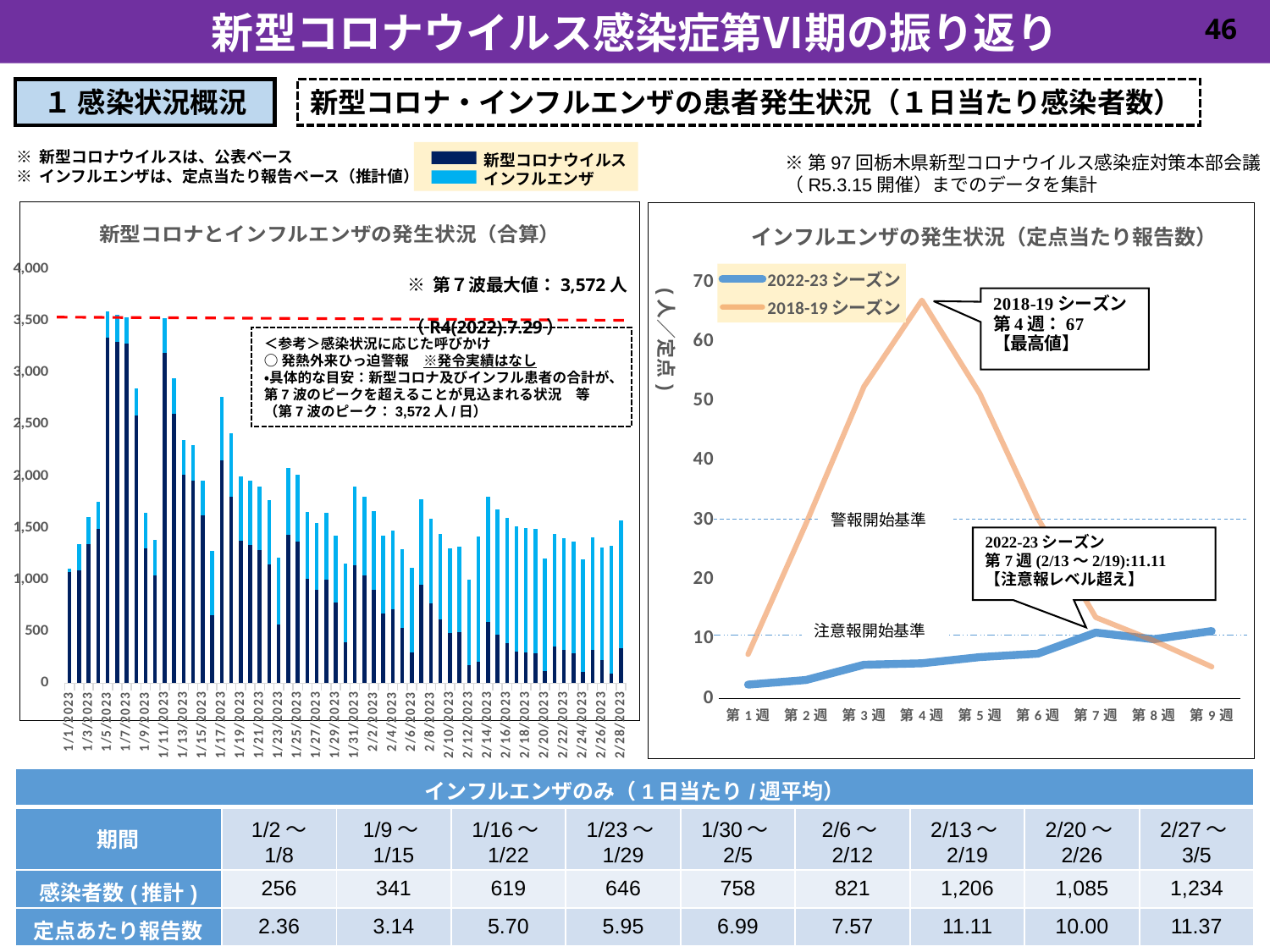
In the right chart インフルエンザの発生状況（定点当たり報告数）, what is the highest value of the 2018-19シーズン series and in which week does it occur? 67, 第4週 In the left chart 新型コロナとインフルエンザの発生状況（合算）, do the stacked totals generally rise or fall from mid-January to the end of February? fall How many series does the legend list for the right chart インフルエンザの発生状況（定点当たり報告数）? 2 What kind of chart is the left chart titled 新型コロナとインフルエンザの発生状況（合算）? bar chart In the right chart インフルエンザの発生状況（定点当たり報告数）, what is the value of the 2022-23シーズン series in 第7週? 11.11 In the left chart 新型コロナとインフルエンザの発生状況（合算）, is the stacked total for 1/1/2023 greater or less than 1,500? less In the right chart インフルエンザの発生状況（定点当たり報告数）, is the 2022-23シーズン value in 第1週 greater or less than 10? less In the right chart インフルエンザの発生状況（定点当たり報告数）, how many weeks are shown on the x axis? 9 What kind of chart is the right chart titled インフルエンザの発生状況（定点当たり報告数）? line chart In the right chart インフルエンザの発生状況（定点当たり報告数）, which series is higher in 第4週, 2022-23シーズン or 2018-19シーズン? 2018-19シーズン In the left chart 新型コロナとインフルエンザの発生状況（合算）, what value is given as the 第7波最大値 marked by the red dashed line? 3,572人 How many series does the legend list for the left chart 新型コロナとインフルエンザの発生状況（合算）? 2